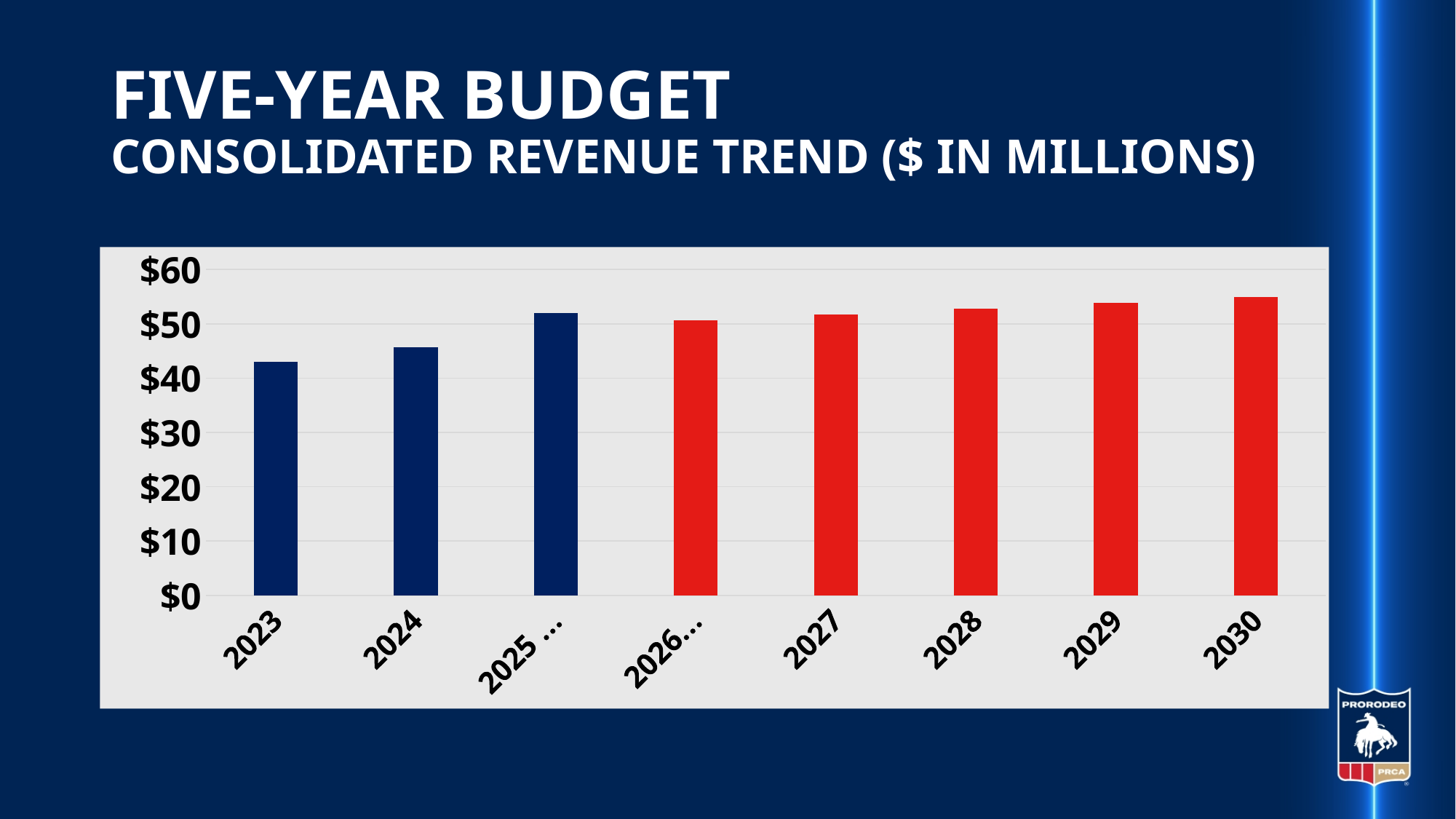
Which is larger, the value for 2024 or the value for 2028? 2028 Which year has the highest revenue bar? 2030 Is the value for 2024 greater or less than $50? less Is the value for 2030 greater or less than $60? less What colour are the bars for 2023, 2024 and 2025? Dark blue How many years (bars) are plotted on the chart? 8 What kind of chart is shown on the slide? Bar chart Is the value for 2023 greater or less than $40? greater Which year has the lowest revenue bar? 2023 Do the revenue values generally rise or fall from 2023 to 2030? Rise